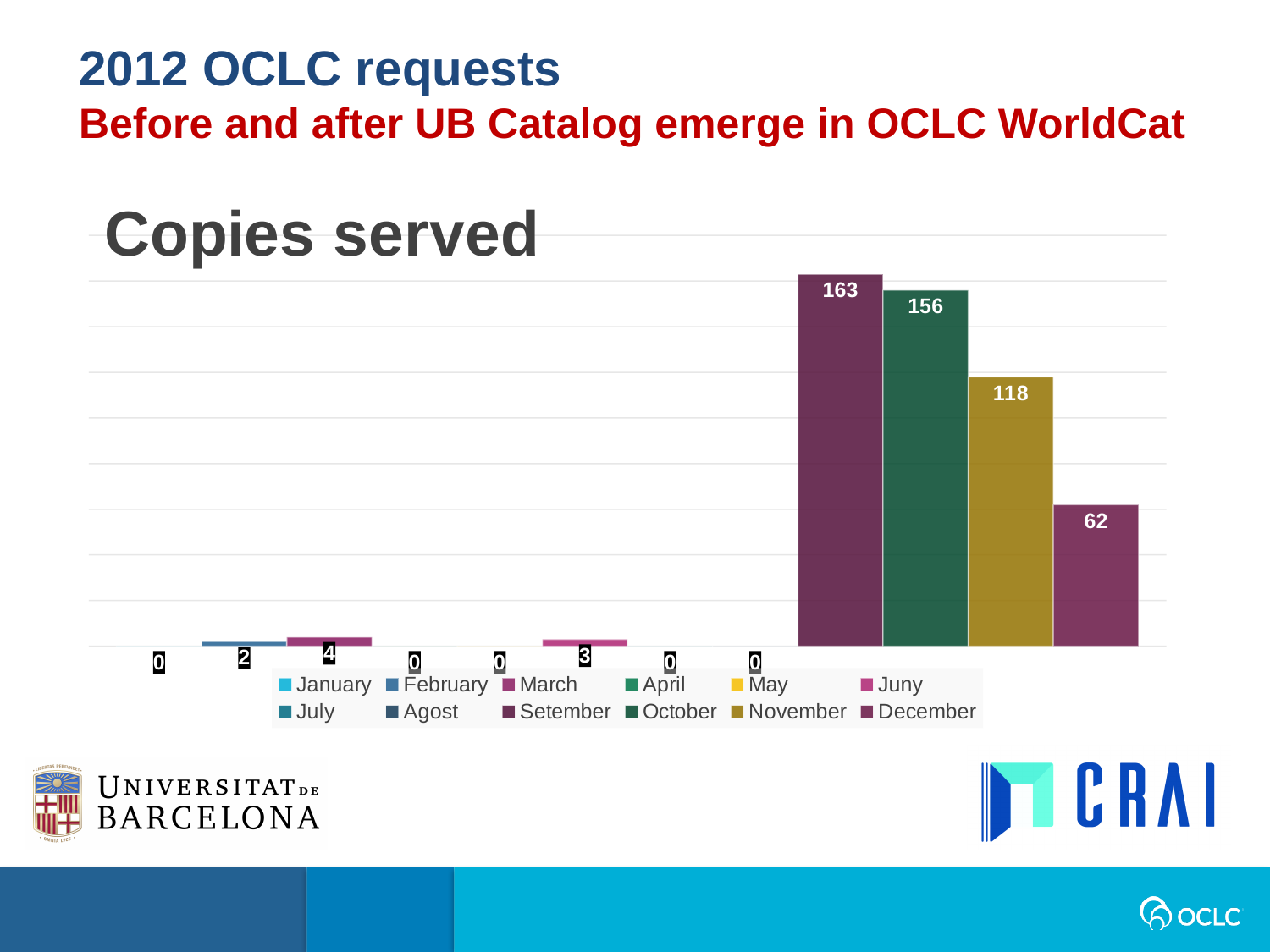
What is the difference between the values for November and December? 56 What is the value for December? 62 Which month has the highest value? Setember How many series does the legend list? 12 What is the title of the chart? Copies served What is the value for Setember? 163 Which is larger, the value for November or the value for December? November What is the difference between the values for Setember and October? 7 What is the value for October? 156 What is the value for March? 4 What is the value for November? 118 What kind of chart is shown on the slide? bar chart